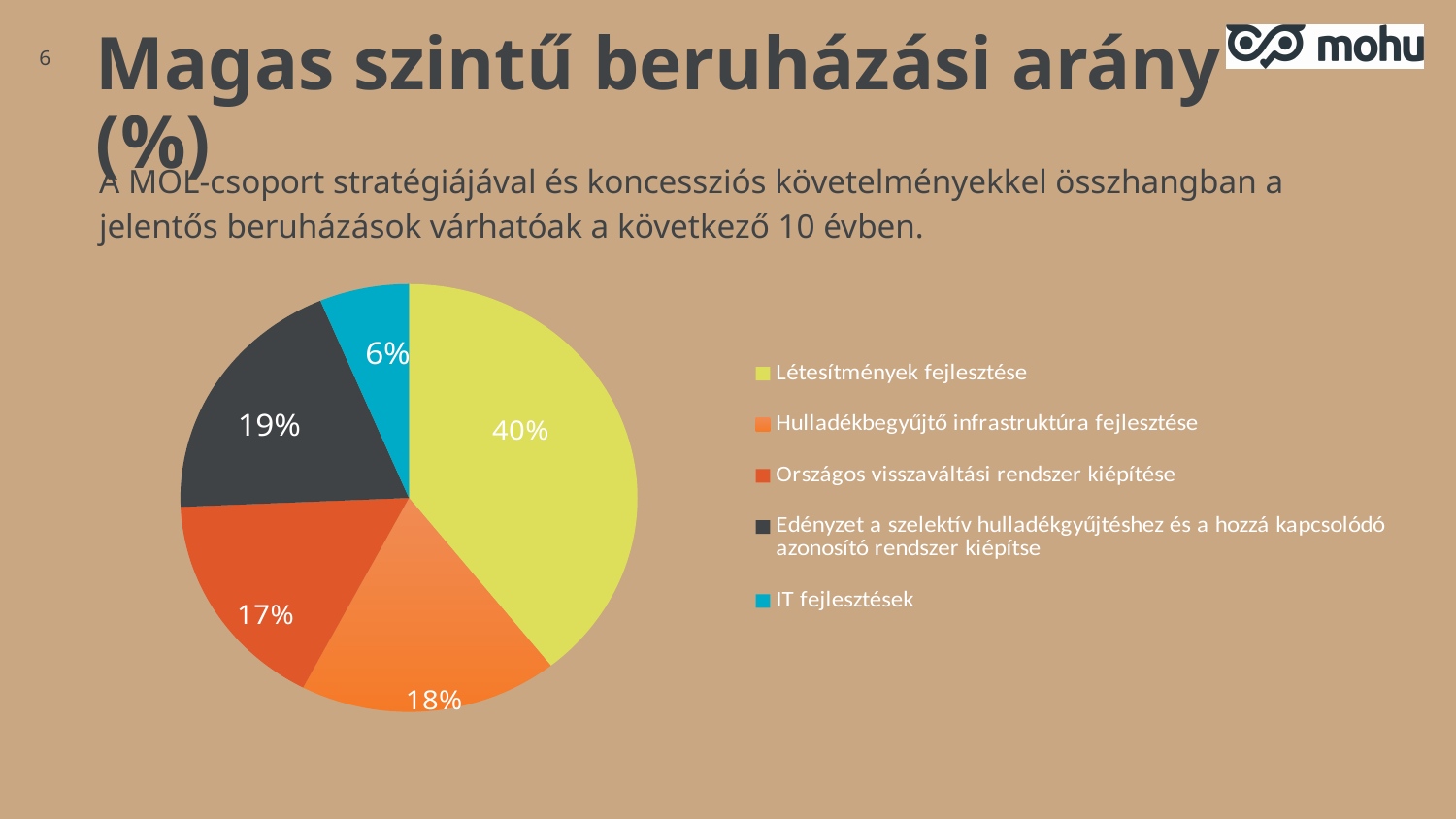
What kind of chart is shown on the slide? pie chart Which category has the smallest share of the pie? IT fejlesztések Which is larger: the share for "Edényzet a szelektív hulladékgyűjtéshez és a hozzá kapcsolódó azonosító rendszer kiépítse" or for "Országos visszaváltási rendszer kiépítése"? Edényzet a szelektív hulladékgyűjtéshez és a hozzá kapcsolódó azonosító rendszer kiépítse How many slices does the pie chart have? 5 What share of the pie does "Hulladékbegyűjtő infrastruktúra fejlesztése" have? 18% What share of the pie does "Országos visszaváltási rendszer kiépítése" have? 17% What is the title of the chart slide? Magas szintű beruházási arány (%) Which category has the largest share of the pie? Létesítmények fejlesztése What share of the pie does "Edényzet a szelektív hulladékgyűjtéshez és a hozzá kapcsolódó azonosító rendszer kiépítse" have? 19% What share of the pie does "Létesítmények fejlesztése" have? 40% What share of the pie does "IT fejlesztések" have? 6% What is the difference in percentage points between "Létesítmények fejlesztése" and "IT fejlesztések"? 34